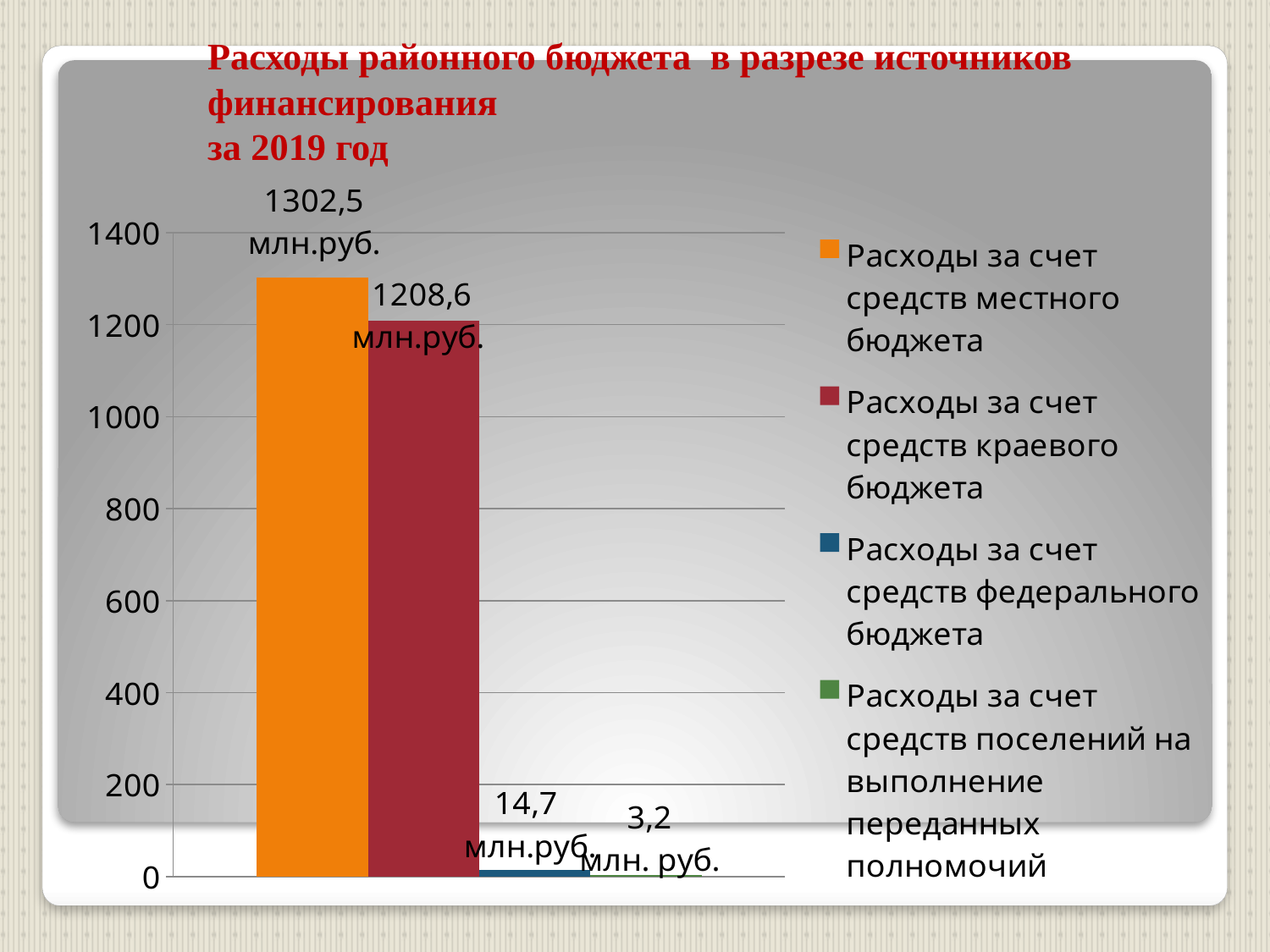
Which is larger: expenses from federal budget funds or expenses from settlement funds? Расходы за счет средств федерального бюджета What is the value for expenses from federal budget funds? 14,7 млн.руб. Is the value for expenses from regional budget funds greater or less than 1000? greater What is the value for expenses from regional (краевого) budget funds? 1208,6 млн.руб. Which funding source has the lowest expenses? Расходы за счет средств поселений на выполнение переданных полномочий What kind of chart is shown on the slide? bar chart What colour is the bar for expenses from regional (краевого) budget funds? red What is the value for expenses from local budget funds (Расходы за счет средств местного бюджета)? 1302,5 млн.руб. Which funding source has the highest expenses? Расходы за счет средств местного бюджета What is the difference between expenses from local budget funds and expenses from regional budget funds? 93,9 млн.руб. How many series does the legend list? 4 What is the value for expenses from settlement funds for delegated powers (средств поселений)? 3,2 млн. руб.